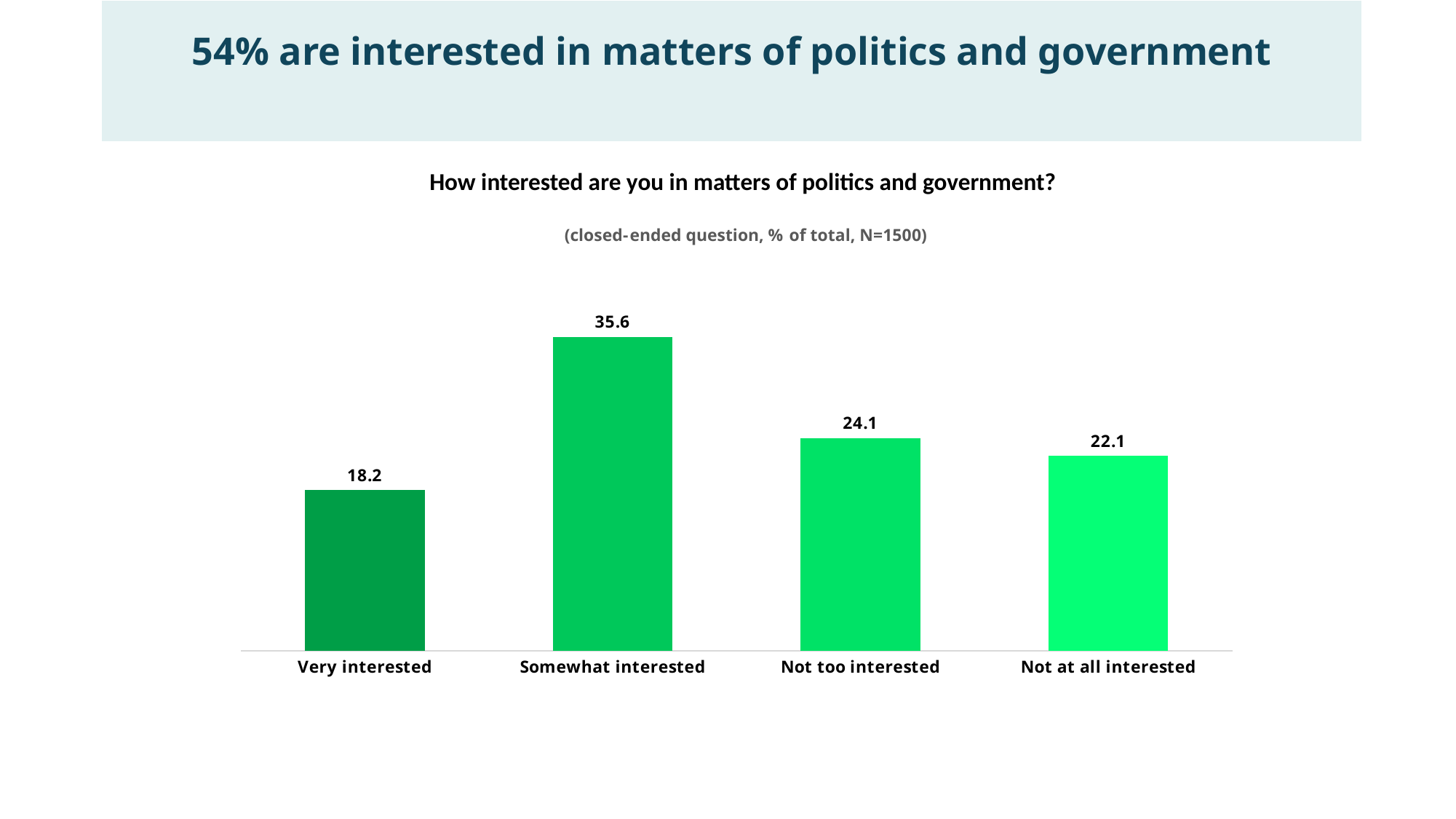
How many categories are shown on the chart? 4 Which category has the lowest value? Very interested What is the value for Not at all interested? 22.1 What kind of chart is shown on the slide? Bar chart What is the value for Somewhat interested? 35.6 What is the value for Very interested? 18.2 Which is larger, the value for Not too interested or the value for Very interested? Not too interested Which category has the highest value? Somewhat interested What is the sample size (N) stated in the chart subtitle? N=1500 What is the difference between the values for Somewhat interested and Very interested? 17.4 What is the difference between the values for Not too interested and Not at all interested? 2.0 What is the value for Not too interested? 24.1